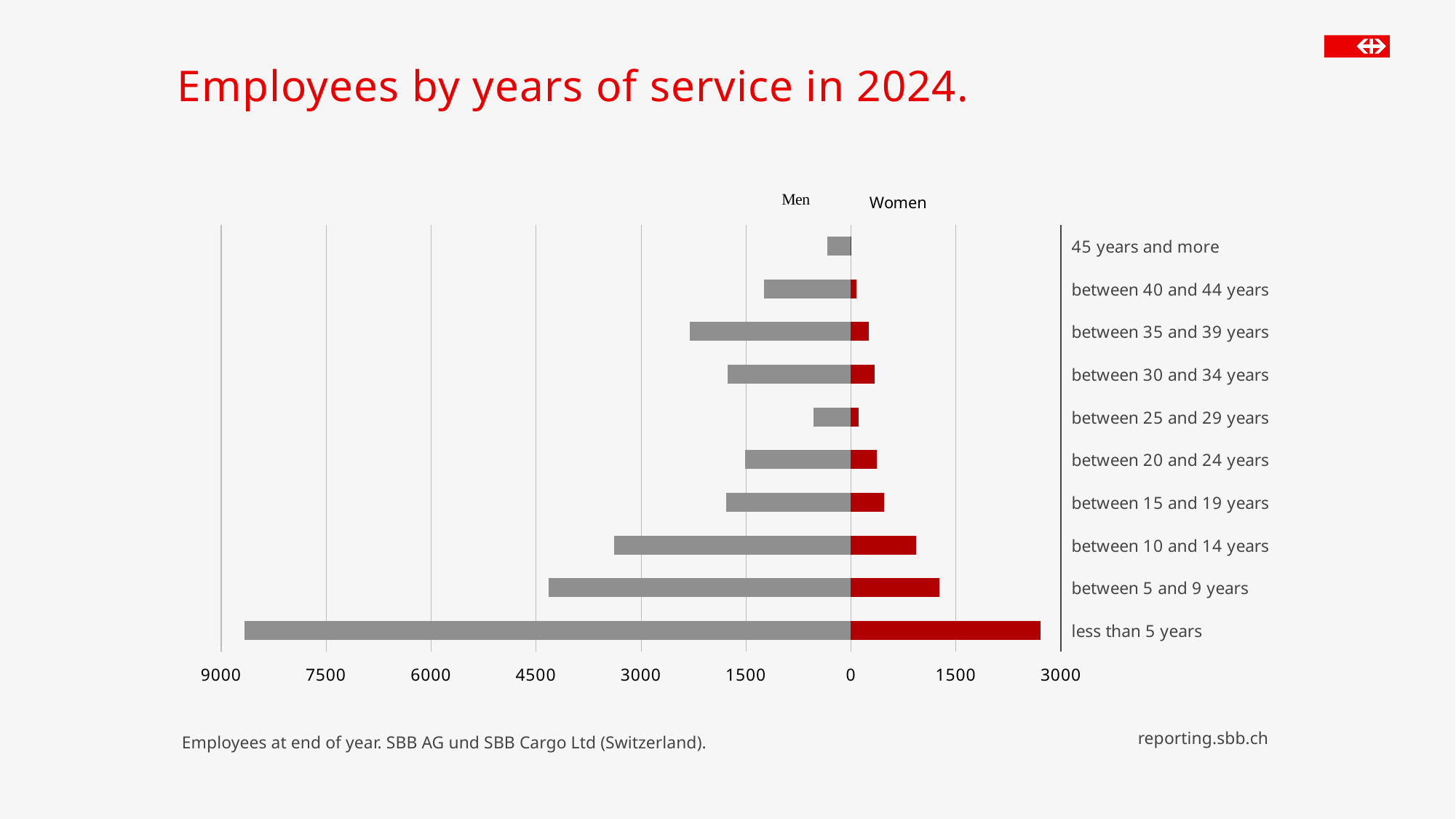
Which years-of-service category has the highest number of men? less than 5 years Is the number of women with less than 5 years of service greater or less than 1500? greater Which colour represents women in the chart? red How many series does the chart show? 2 Is the number of men with between 10 and 14 years of service greater or less than 3000? greater What kind of chart is shown on the slide? bar chart Is the number of men with less than 5 years of service greater or less than 7500? greater Which years-of-service category has the lowest number of men? 45 years and more How many years-of-service categories are shown in the chart? 10 Which years-of-service category has the highest number of women? less than 5 years For employees with less than 5 years of service, are there more men or more women? Men